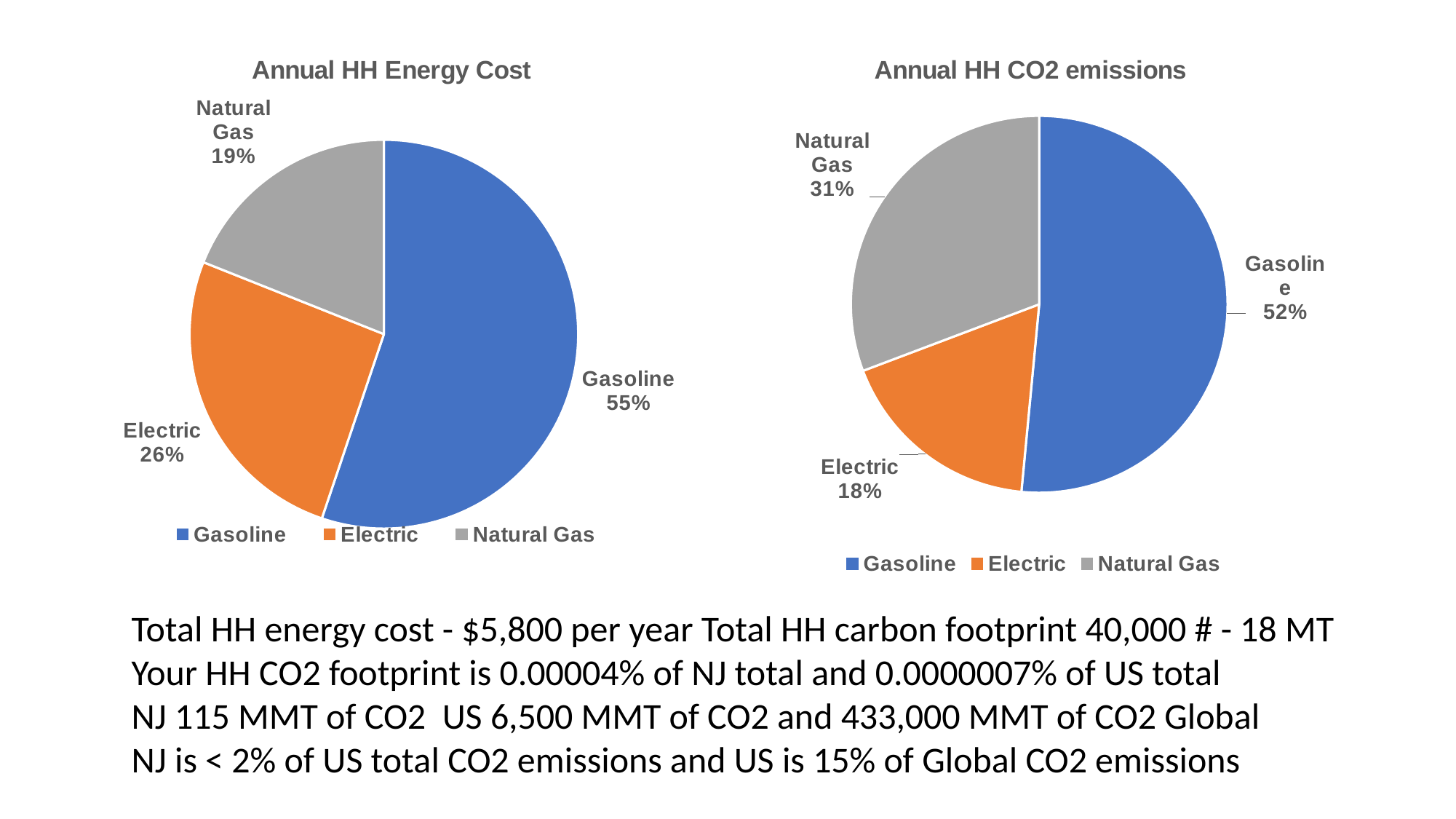
In the 'Annual HH Energy Cost' chart, what share does Electric have? 26% In the 'Annual HH Energy Cost' chart, what share does Natural Gas have? 19% In the 'Annual HH CO2 emissions' chart, which category has the largest slice? Gasoline In the 'Annual HH Energy Cost' chart, what is the difference in percentage points between Gasoline and Electric? 29 What type of chart is the 'Annual HH Energy Cost' chart? Pie chart How many categories does the legend of the 'Annual HH CO2 emissions' chart list? 3 In the 'Annual HH CO2 emissions' chart, what share does Electric have? 18% In the 'Annual HH CO2 emissions' chart, which category has the smallest slice? Electric In the 'Annual HH Energy Cost' chart, which category has the smallest slice? Natural Gas In the 'Annual HH CO2 emissions' chart, which is larger, Natural Gas or Electric? Natural Gas